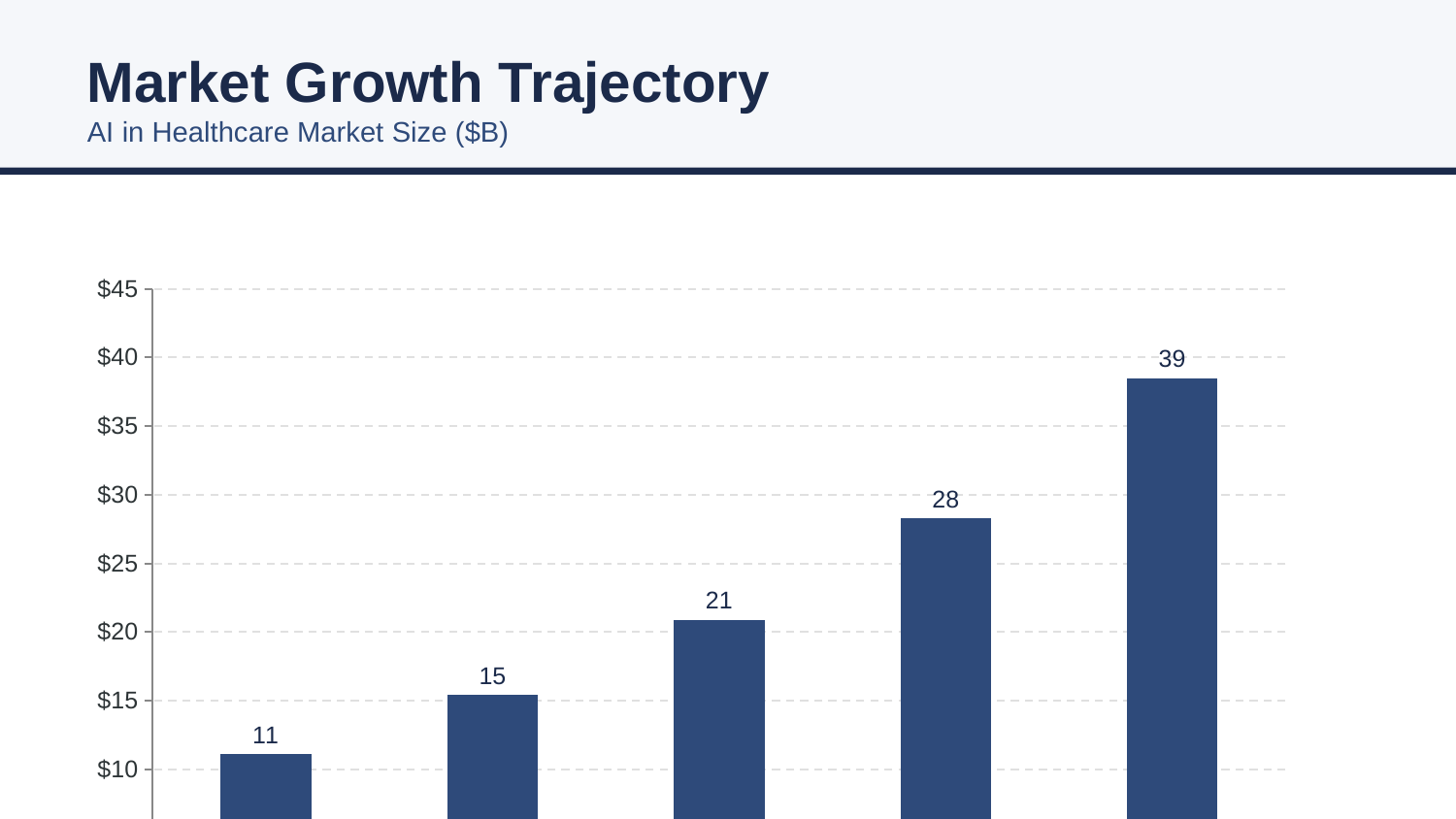
Do the bar values rise or fall from left to right? rise What is the value labelled on the tallest bar? 39 What is the value labelled on the third bar from the left? 21 Is the value of the rightmost bar greater or less than $40? less Which is larger, the second bar from the left or the third bar from the left? the third bar What is the difference between the fourth bar and the third bar from the left? 7 What kind of chart is shown on the slide? bar chart What is the difference between the rightmost bar and the leftmost bar? 28 What is the value labelled on the fourth bar from the left? 28 What is the value labelled on the shortest bar? 11 What unit does the chart subtitle say the market size is measured in? $B How many bars are plotted in the chart? 5